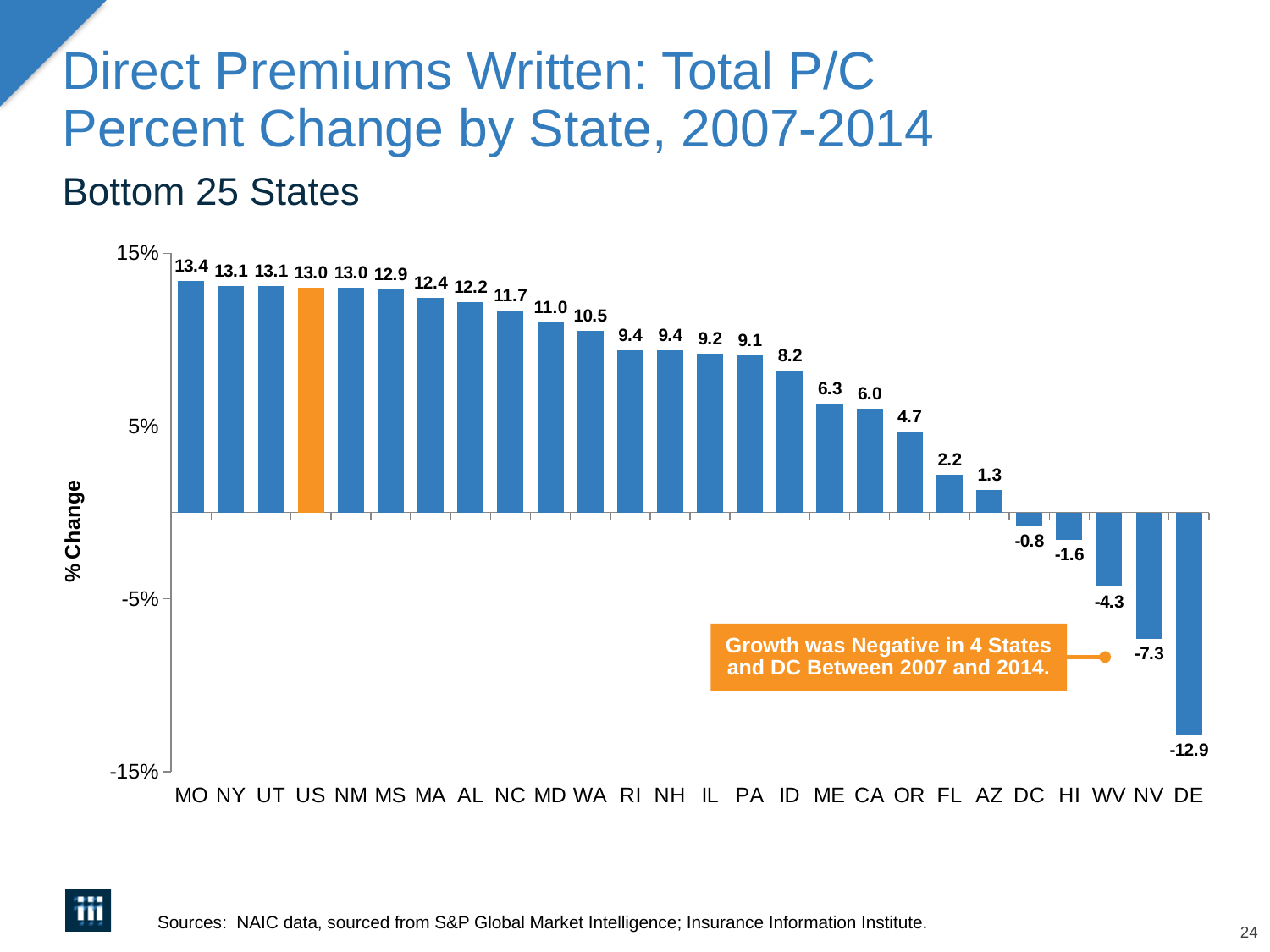
What is the percent change for DE? -12.9 Which bar is coloured orange instead of blue? US What kind of chart is shown on the slide? bar chart Do the values rise or fall moving from left to right along the x axis? fall Which category has the highest percent change? MO Which state has the lowest percent change? DE What is the percent change for MO? 13.4 Which has a larger percent change, OR or FL? OR What is the percent change for the US bar? 13.0 What is the difference between the percent change for ME and CA? 0.3 How many bars are shown in the chart? 26 Is the value for ID greater or less than 5%? greater